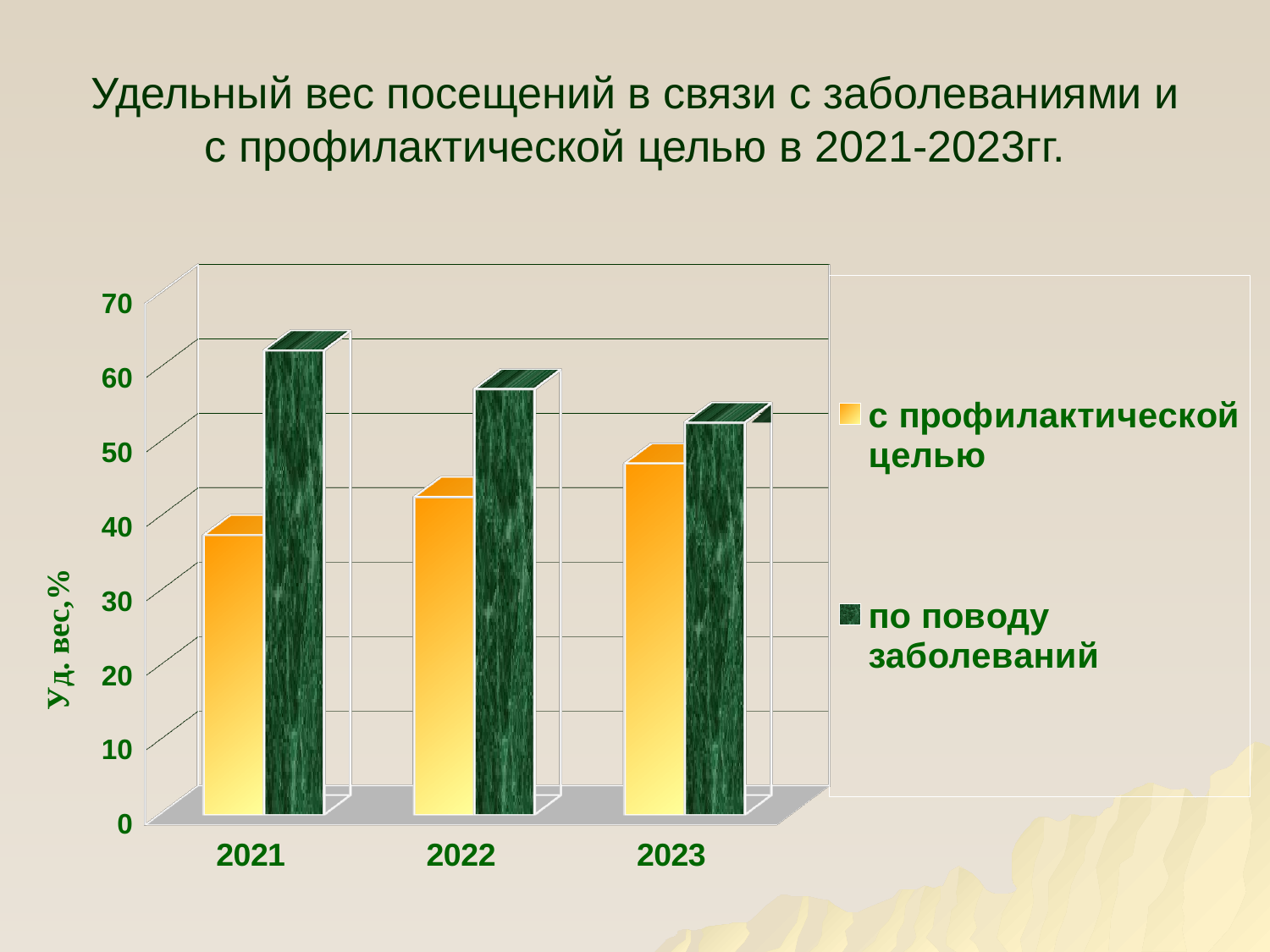
In which year is the value for "по поводу заболеваний" highest? 2021 Do the values for "по поводу заболеваний" rise or fall from 2021 to 2023? fall What is the label of the vertical axis? Уд. вес, % How many series does the legend list? 2 In 2021, which is larger: "с профилактической целью" or "по поводу заболеваний"? по поводу заболеваний How many years are shown on the x axis? 3 In which year is the value for "с профилактической целью" lowest? 2021 Is the value for "с профилактической целью" in 2022 greater or less than 40? greater What kind of chart is shown on the slide? bar chart Do the values for "с профилактической целью" rise or fall from 2021 to 2023? rise Is the value for "по поводу заболеваний" in 2021 greater or less than 60? greater Which series is represented by the green bars? по поводу заболеваний